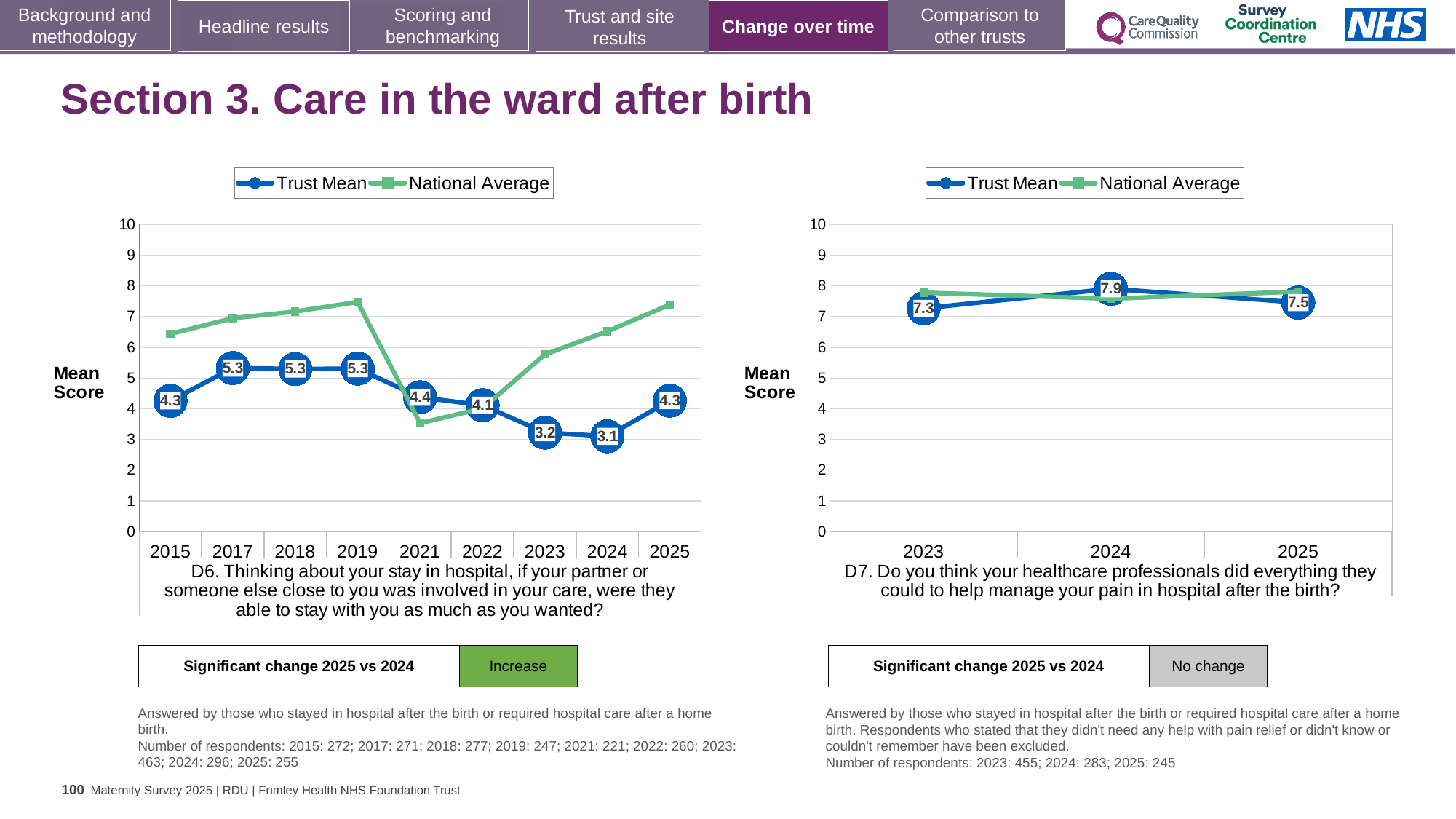
In the left chart (D6), which year has the lowest Trust Mean score? 2024 In the left chart (D6), what is the Trust Mean score for 2025? 4.3 How many series does the legend of the right chart (D7) list? 2 In the right chart (D7), what is the difference between the Trust Mean scores for 2024 and 2023? 0.6 In the right chart (D7), which year has the highest Trust Mean score? 2024 In the left chart (D6), is the Trust Mean for 2019 larger or smaller than the Trust Mean for 2023? larger In the left chart (D6), what is the difference between the Trust Mean scores for 2025 and 2024? 1.2 In the left chart (D6), how many years are shown on the x axis? 9 What type of chart is the left chart (D6)? Line chart In the left chart (D6), is the National Average for 2025 greater or less than 7? greater In the left chart (D6), what is the Trust Mean score for 2024? 3.1 In the right chart (D7), what is the Trust Mean score for 2024? 7.9